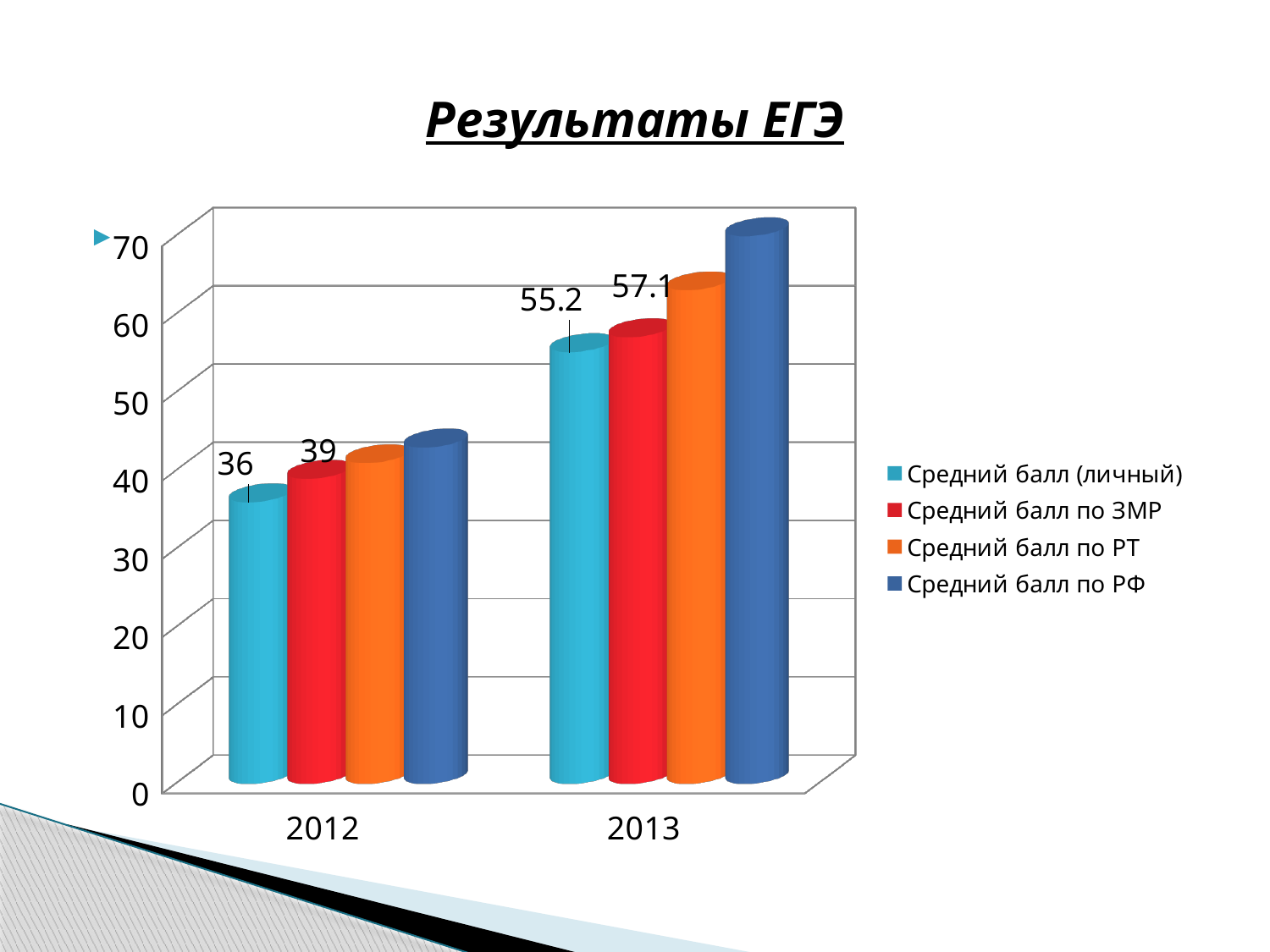
What kind of chart is shown on the slide? bar chart What is the value for Средний балл по ЗМР in 2013? 57.1 Which is larger in 2013: Средний балл (личный) or Средний балл по ЗМР? Средний балл по ЗМР What is the difference between Средний балл по ЗМР and Средний балл (личный) in 2012? 3 Which series has the highest value in 2013? Средний балл по РФ How many series does the legend list? 4 Do the values rise or fall from 2012 to 2013? rise What is the value for Средний балл (личный) in 2012? 36 By how much did Средний балл (личный) change from 2012 to 2013? 19.2 What is the value for Средний балл (личный) in 2013? 55.2 Is the value for Средний балл по РФ in 2012 greater or less than 50? less Is the value for Средний балл по РФ in 2013 greater or less than 60? greater